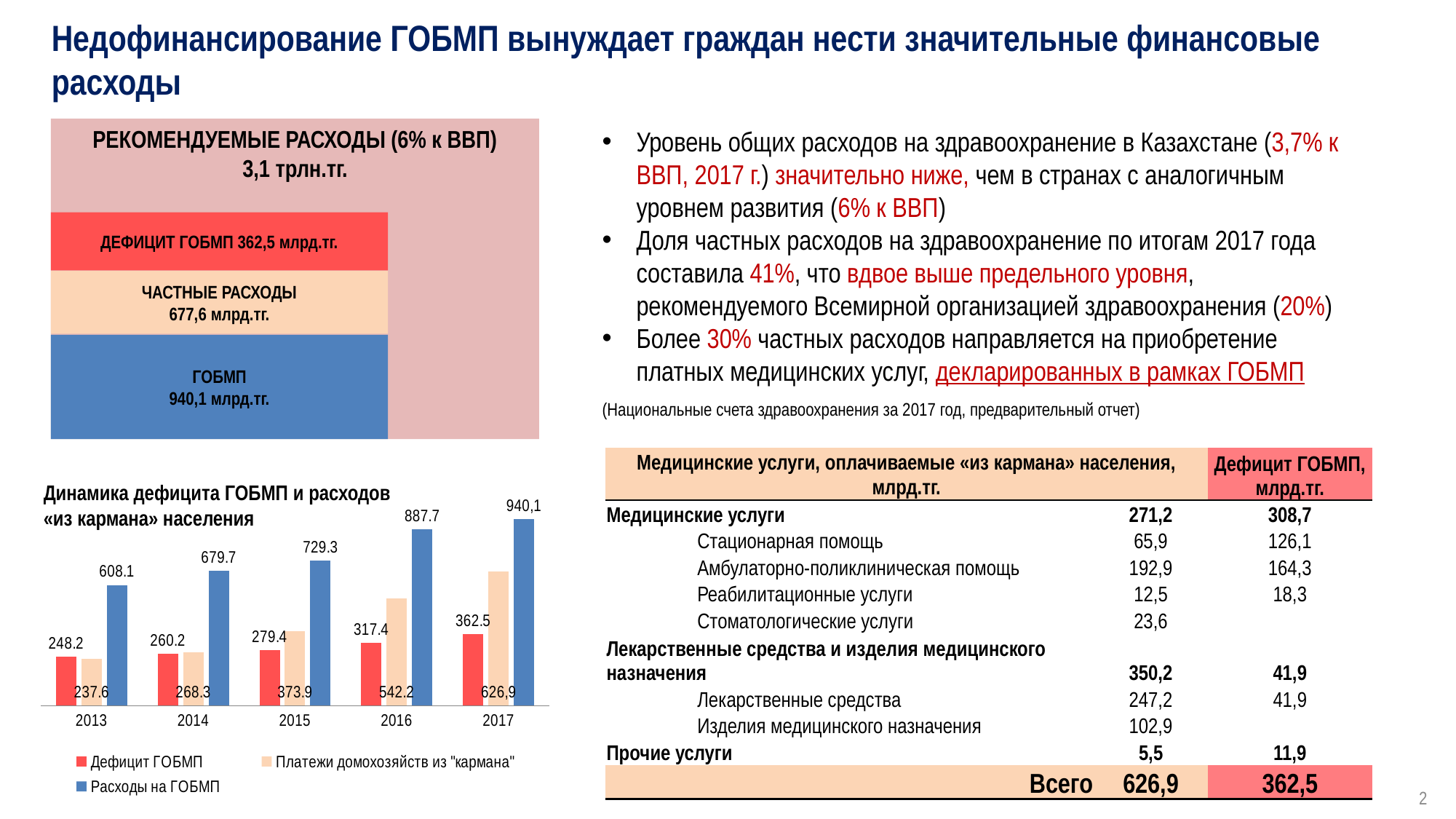
In the chart «Динамика дефицита ГОБМП и расходов «из кармана» населения», which year has the highest value for Расходы на ГОБМП? 2017 In the chart «Динамика дефицита ГОБМП и расходов «из кармана» населения», which colour represents Расходы на ГОБМП? blue In the chart «Динамика дефицита ГОБМП и расходов «из кармана» населения», what is the difference between Расходы на ГОБМП in 2017 and in 2016? 52.4 In the chart «Динамика дефицита ГОБМП и расходов «из кармана» населения», what is the value of Дефицит ГОБМП for 2017? 362.5 What kind of chart is «Динамика дефицита ГОБМП и расходов «из кармана» населения»? bar chart How many years are shown on the x axis of the chart «Динамика дефицита ГОБМП и расходов «из кармана» населения»? 5 In the chart «Динамика дефицита ГОБМП и расходов «из кармана» населения», which is larger in 2015: Дефицит ГОБМП or Платежи домохозяйств из "кармана"? Платежи домохозяйств из "кармана" How many series does the legend of the chart «Динамика дефицита ГОБМП и расходов «из кармана» населения» list? 3 In the chart «Динамика дефицита ГОБМП и расходов «из кармана» населения», what is the value of Платежи домохозяйств из "кармана" for 2016? 542.2 In the chart «Динамика дефицита ГОБМП и расходов «из кармана» населения», what is the value of Расходы на ГОБМП for 2013? 608.1 In the chart «Динамика дефицита ГОБМП и расходов «из кармана» населения», do the values for Дефицит ГОБМП rise or fall from 2013 to 2017? rise In the chart «Динамика дефицита ГОБМП и расходов «из кармана» населения», which year has the lowest value for Платежи домохозяйств из "кармана"? 2013